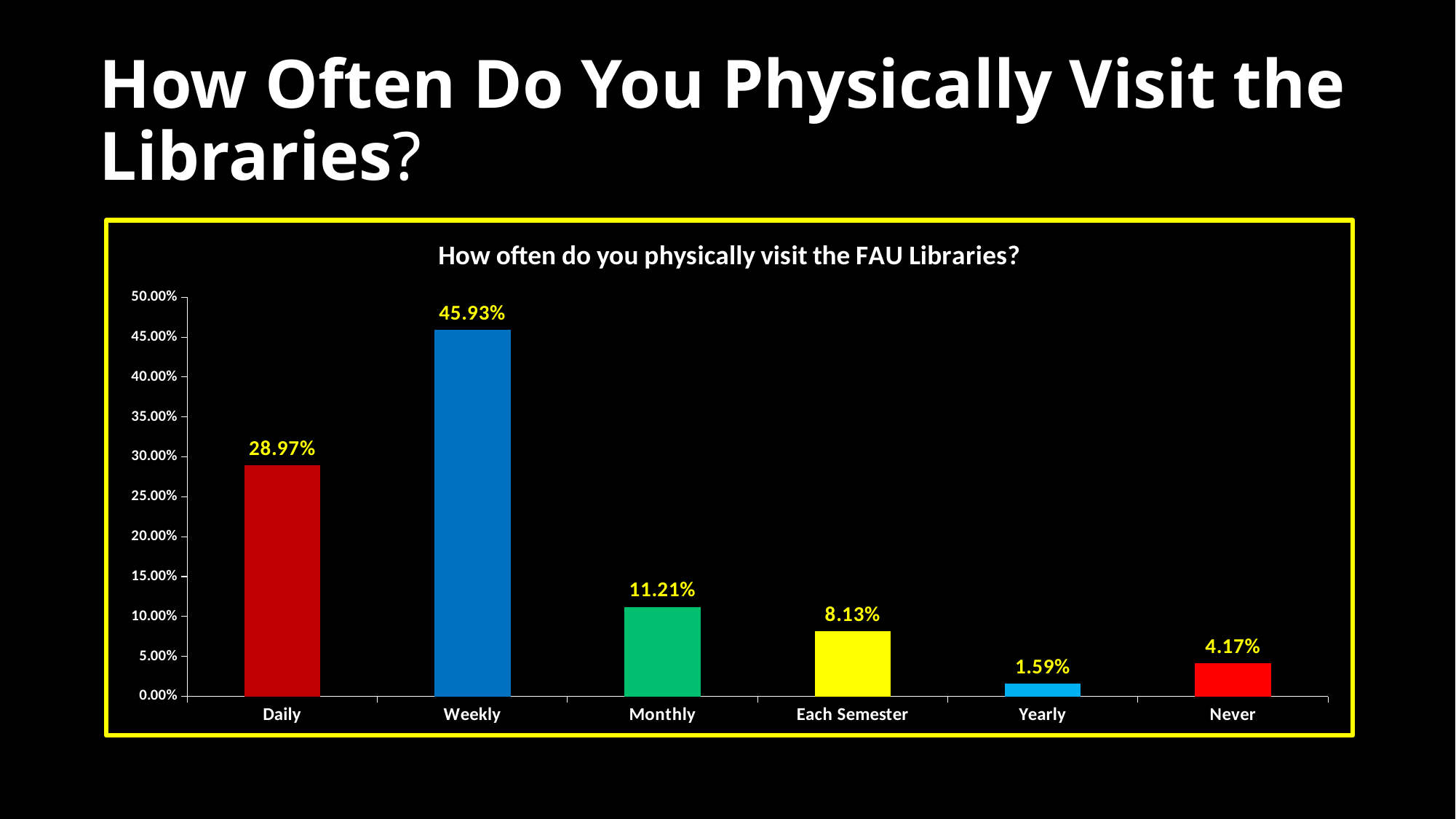
How many categories are shown on the x axis? 6 Which category has the highest value? Weekly What percentage of respondents said they never physically visit the libraries? 4.17% Which is larger, the value for Monthly or the value for Never? Monthly What is the difference between the Monthly and Each Semester values? 3.08% Is the value for Each Semester greater or less than 10.00%? less Which category has the lowest value? Yearly What is the difference between the Weekly and Daily values? 16.96% What percentage of respondents visit the FAU Libraries weekly? 45.93% What is the value shown for the Daily category? 28.97% What is the title of the chart? How often do you physically visit the FAU Libraries? What kind of chart is shown on the slide? Bar chart